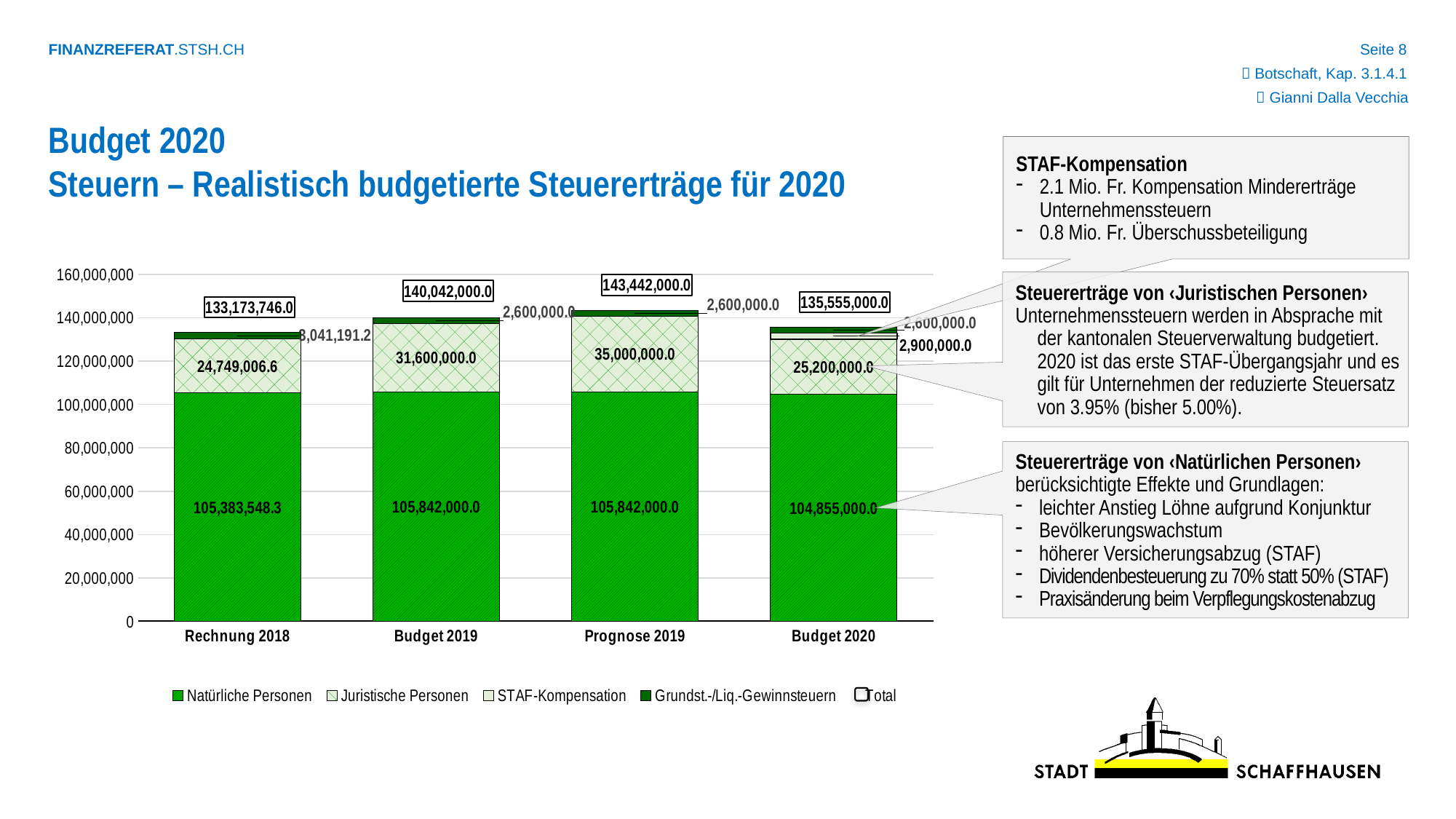
Which category has the highest Total value? Prognose 2019 Which category is the only one that includes a STAF-Kompensation segment? Budget 2020 Which category has the lowest Total value? Rechnung 2018 What is the difference between the Juristische Personen values for Prognose 2019 and Budget 2020? 9,800,000.0 Which is larger, the Natürliche Personen value for Rechnung 2018 or for Budget 2020? Rechnung 2018 How many series does the chart legend list? 5 How many categories are shown on the x axis of the chart? 4 Is the Total value for Budget 2020 greater or less than 140,000,000? less What is the Total value for Prognose 2019? 143,442,000.0 What is the STAF-Kompensation value in Budget 2020? 2,900,000.0 What is the value for Juristische Personen in Budget 2019? 31,600,000.0 What kind of chart is shown on the slide? Stacked bar chart